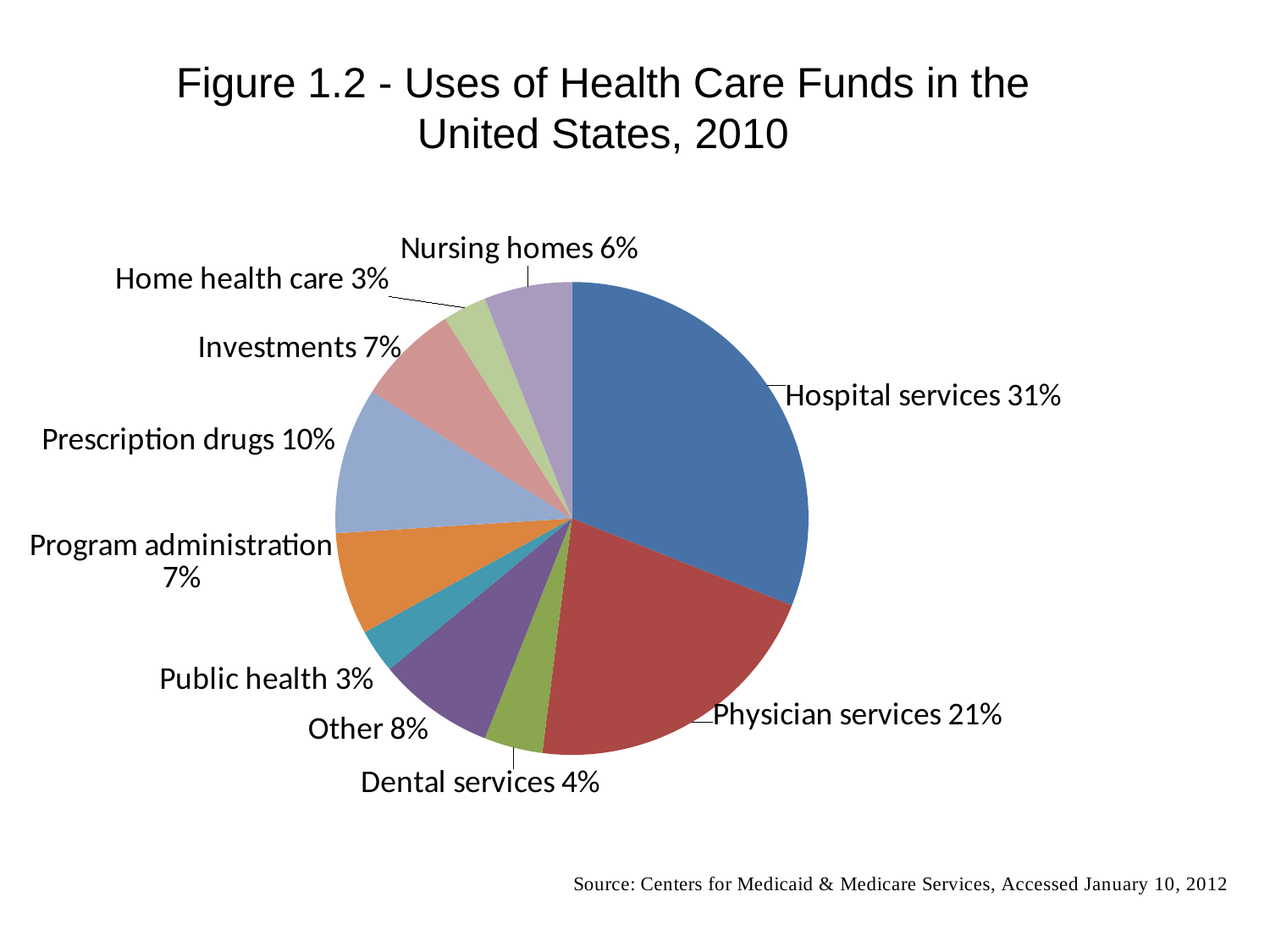
What percentage is shown for Physician services? 21% What share of health care funds goes to Hospital services? 31% What percentage is shown for Prescription drugs? 10% How many slices does the pie chart have? 10 What percentage is shown for Dental services? 4% Which is larger, the share for Other or the share for Investments? Other What is the combined share of Hospital services and Physician services? 52% What percentage is shown for Nursing homes? 6% What is the difference in percentage points between Hospital services and Physician services? 10 Which category has the largest slice of the pie? Hospital services What is the title of the chart? Figure 1.2 - Uses of Health Care Funds in the United States, 2010 What kind of chart is shown on the slide? pie chart